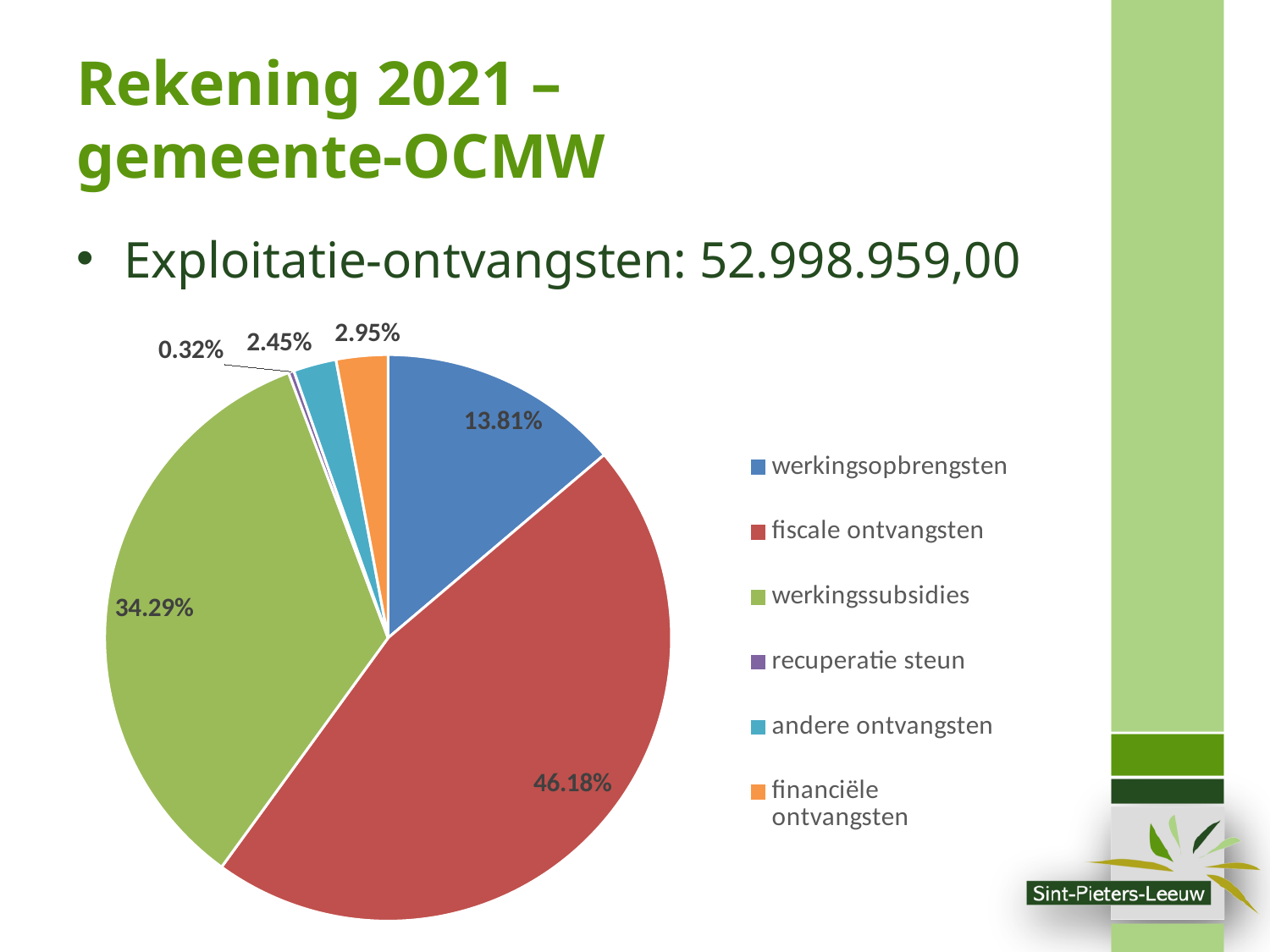
What share of the pie does werkingssubsidies represent? 34.29% Which colour represents werkingssubsidies in the legend? green What kind of chart is shown on the slide? pie chart What share of the pie does werkingsopbrengsten represent? 13.81% What share of the pie does recuperatie steun represent? 0.32% Which category has the smallest slice of the pie? recuperatie steun What is the difference in percentage points between fiscale ontvangsten and werkingssubsidies? 11.89 Which category has the largest slice of the pie? fiscale ontvangsten What share of the pie does financiële ontvangsten represent? 2.95% How many categories does the pie chart show? 6 What share of the pie does fiscale ontvangsten represent? 46.18% Which is larger, the slice for andere ontvangsten or the slice for financiële ontvangsten? financiële ontvangsten